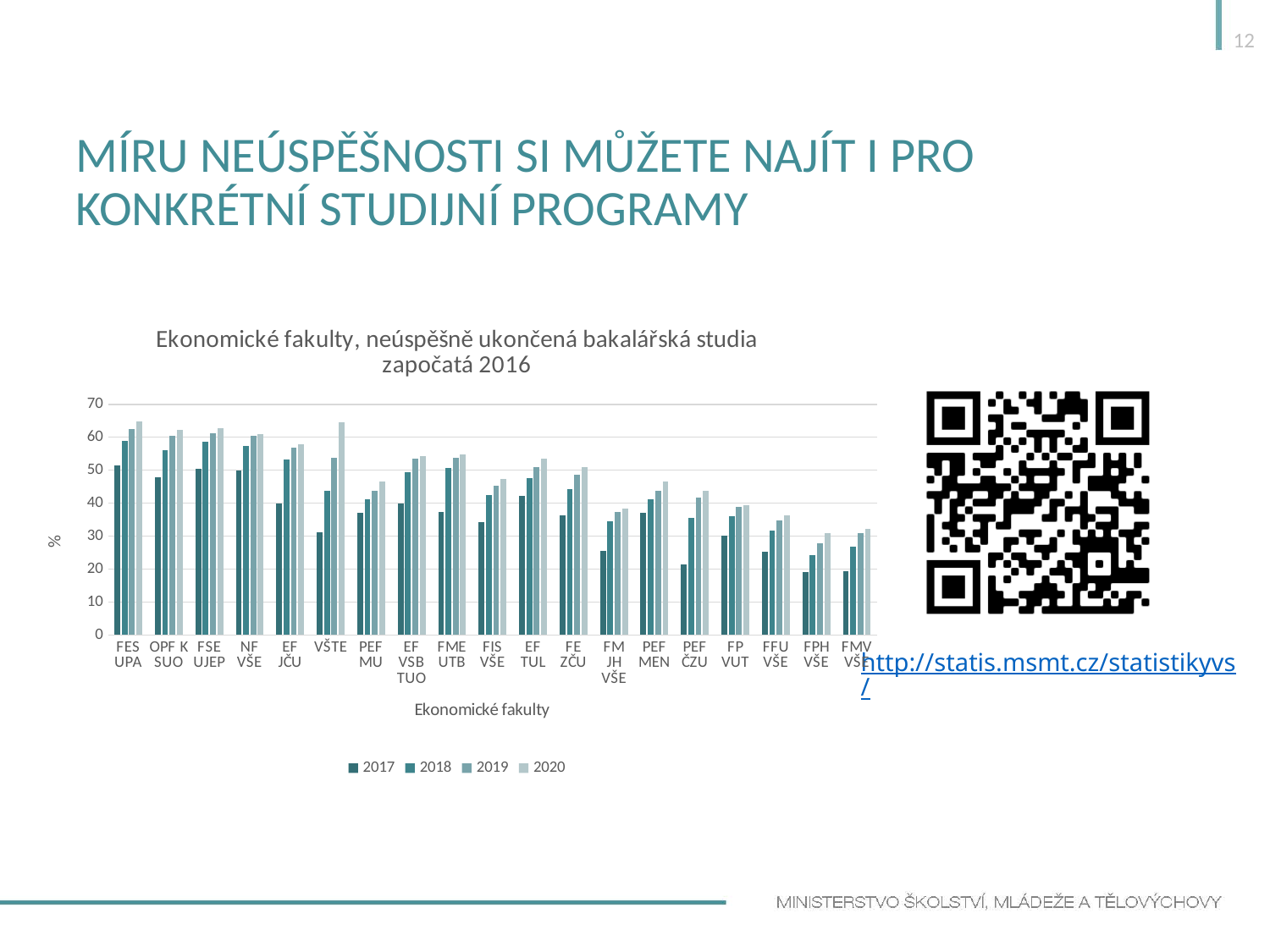
Which is larger, the 2020 value for NF VŠE or the 2020 value for PEF MU? NF VŠE What kind of chart is shown on the slide? bar chart Is the 2017 value for FM JH VŠE greater or less than 30? less Is the 2020 value for FFU VŠE greater or less than 40? less What is the title of the chart? Ekonomické fakulty, neúspěšně ukončená bakalářská studia započatá 2016 How many faculties (categories) are shown on the x axis? 19 For FES UPA, do the values rise or fall from 2017 to 2020? rise Is the 2020 value for FES UPA greater or less than 60? greater How many series does the legend list? 4 Which is larger, the 2017 value for FES UPA or the 2017 value for FMV VŠE? FES UPA